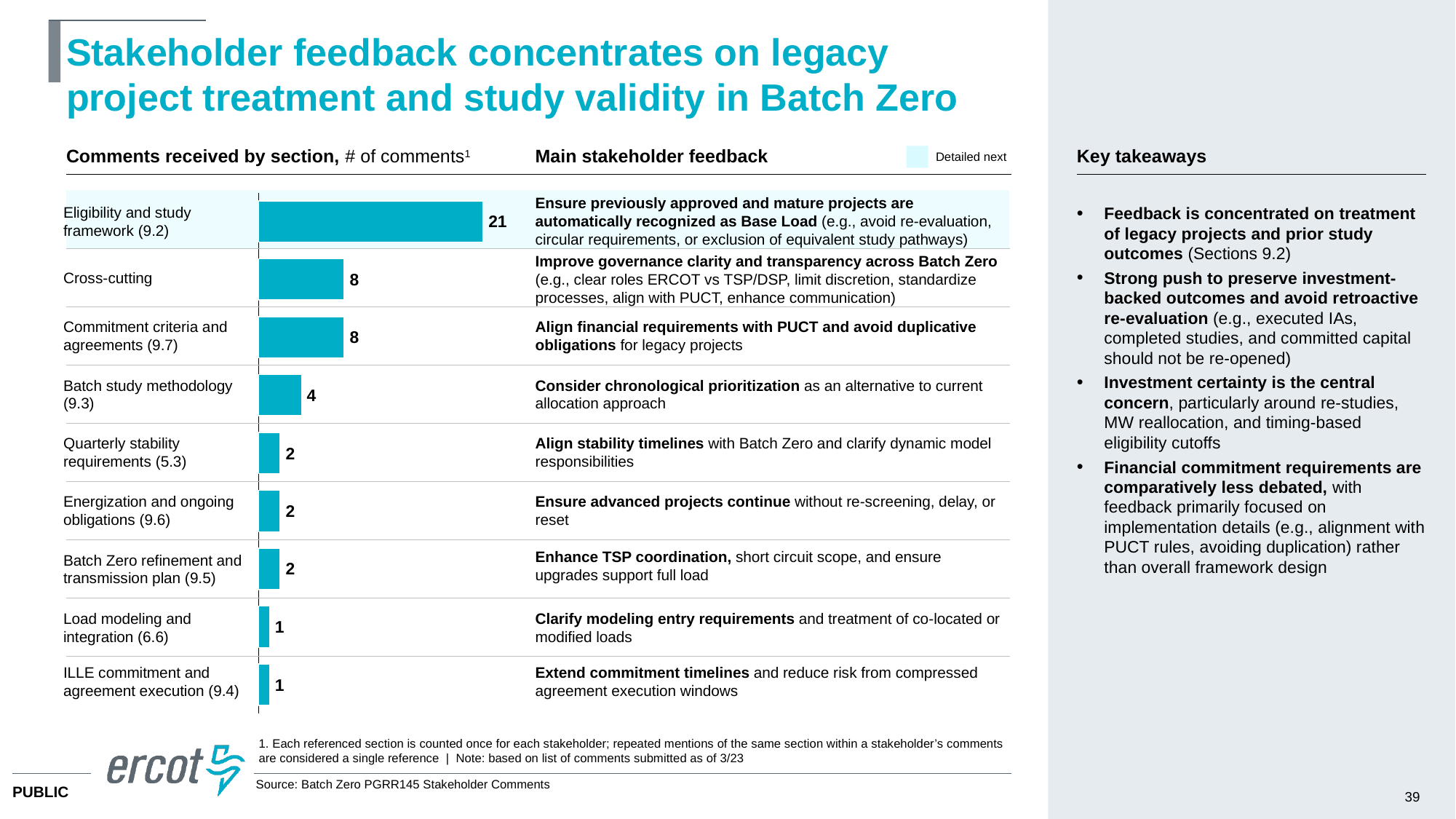
What is the difference in number of comments between Commitment criteria and agreements (9.7) and Batch study methodology (9.3)? 4 How many comments were received for the Load modeling and integration (6.6) section? 1 How many sections received exactly 2 comments? 3 How many comments were received for the Cross-cutting section? 8 How many sections are shown in the chart? 9 What is the difference in number of comments between Eligibility and study framework (9.2) and Cross-cutting? 13 What kind of chart is used to show comments received by section? Bar chart Which section received the most comments? Eligibility and study framework (9.2) What is the title of the chart? Comments received by section, # of comments How many comments were received for the Batch study methodology (9.3) section? 4 How many comments were received for the Eligibility and study framework (9.2) section? 21 Which received more comments: Batch study methodology (9.3) or Quarterly stability requirements (5.3)? Batch study methodology (9.3)